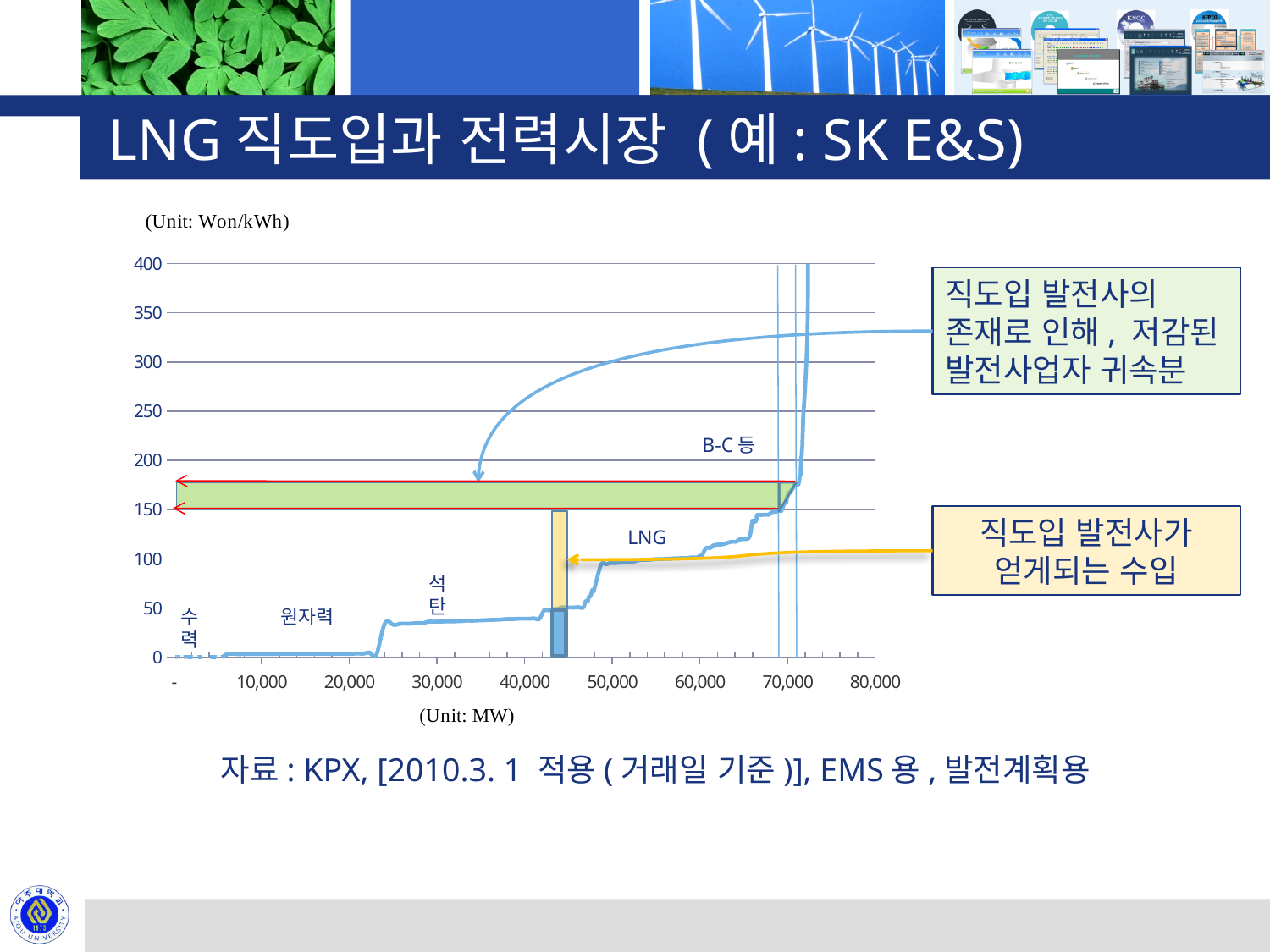
How many fuel types are labeled along the curve on the chart? 5 Is the value of the curve at 65,000 MW greater or less than 100? greater Which fuel type labeled on the chart is located at the far right, at the highest values? B-C 등 Is the value of the curve at 30,000 MW greater or less than 50? less What kind of chart is shown on the slide? line chart Which fuel type labeled on the chart is located at the far left, at the lowest values? 수력 What is the highest tick value shown on the vertical axis of the chart? 400 Do the values on the chart rise or fall as you move from left to right along the x axis? rise Is the value of the curve at 65,000 MW greater or less than 150? less What unit is shown for the horizontal axis of the chart? MW What unit is shown for the vertical axis of the chart? Won/kWh